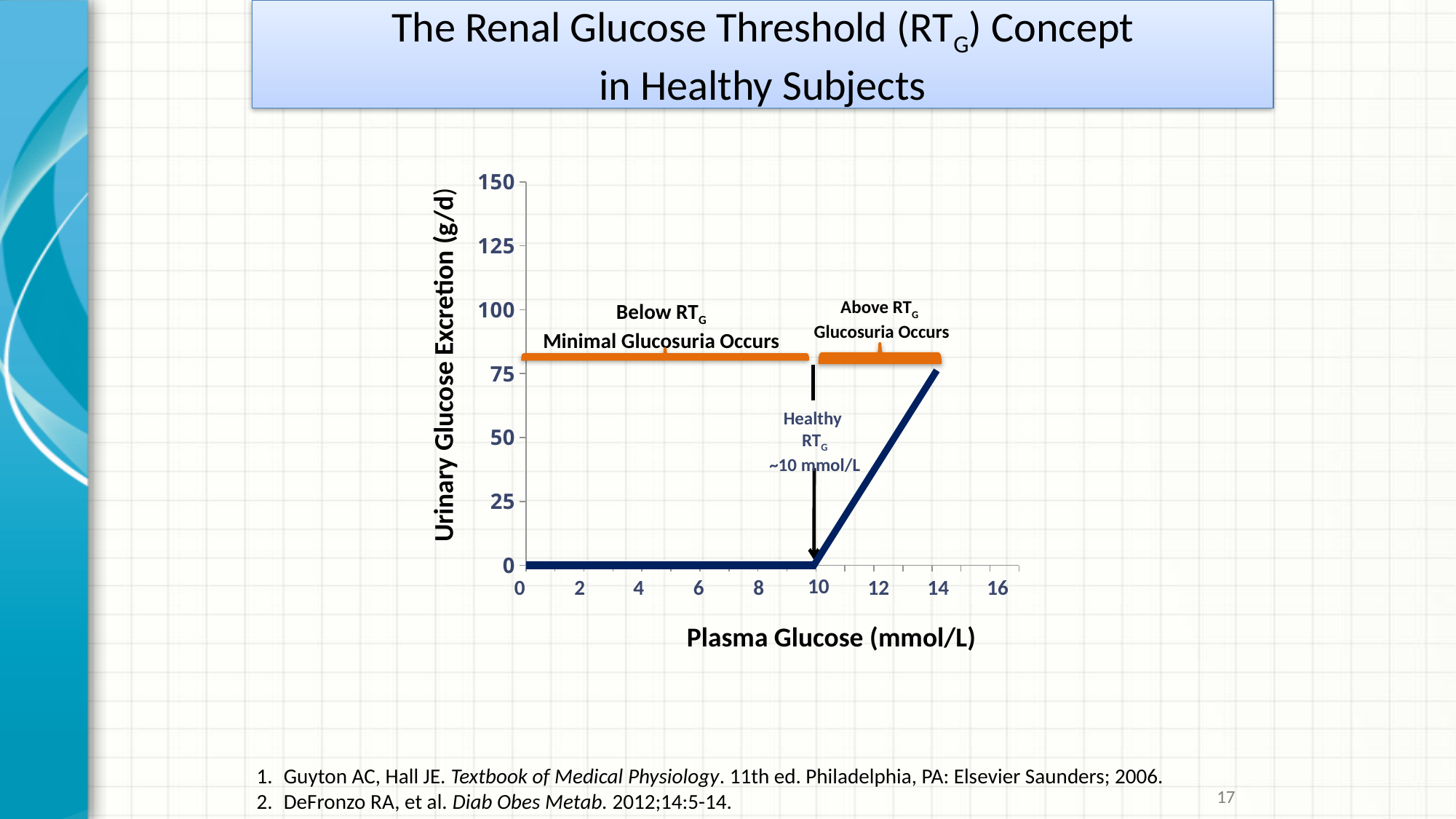
Is the urinary glucose excretion at a plasma glucose of 12 mmol/L greater or less than 50? less How many data series are plotted on the chart? 1 What is the label of the y axis? Urinary Glucose Excretion (g/d) What is the label of the x axis? Plasma Glucose (mmol/L) What is the urinary glucose excretion value at a plasma glucose of 6 mmol/L? 0 What is the highest value shown on the y axis? 150 What kind of chart is shown on the slide? Line chart What is the urinary glucose excretion value at a plasma glucose of 14 mmol/L? 75 What plasma glucose value is given for the healthy renal glucose threshold (RTG) on the chart? ~10 mmol/L Which is larger, the urinary glucose excretion at 8 mmol/L or at 14 mmol/L plasma glucose? 14 mmol/L Does urinary glucose excretion rise or fall as plasma glucose increases from 10 to 14 mmol/L? rise Is the urinary glucose excretion at a plasma glucose of 12 mmol/L greater or less than 25? greater